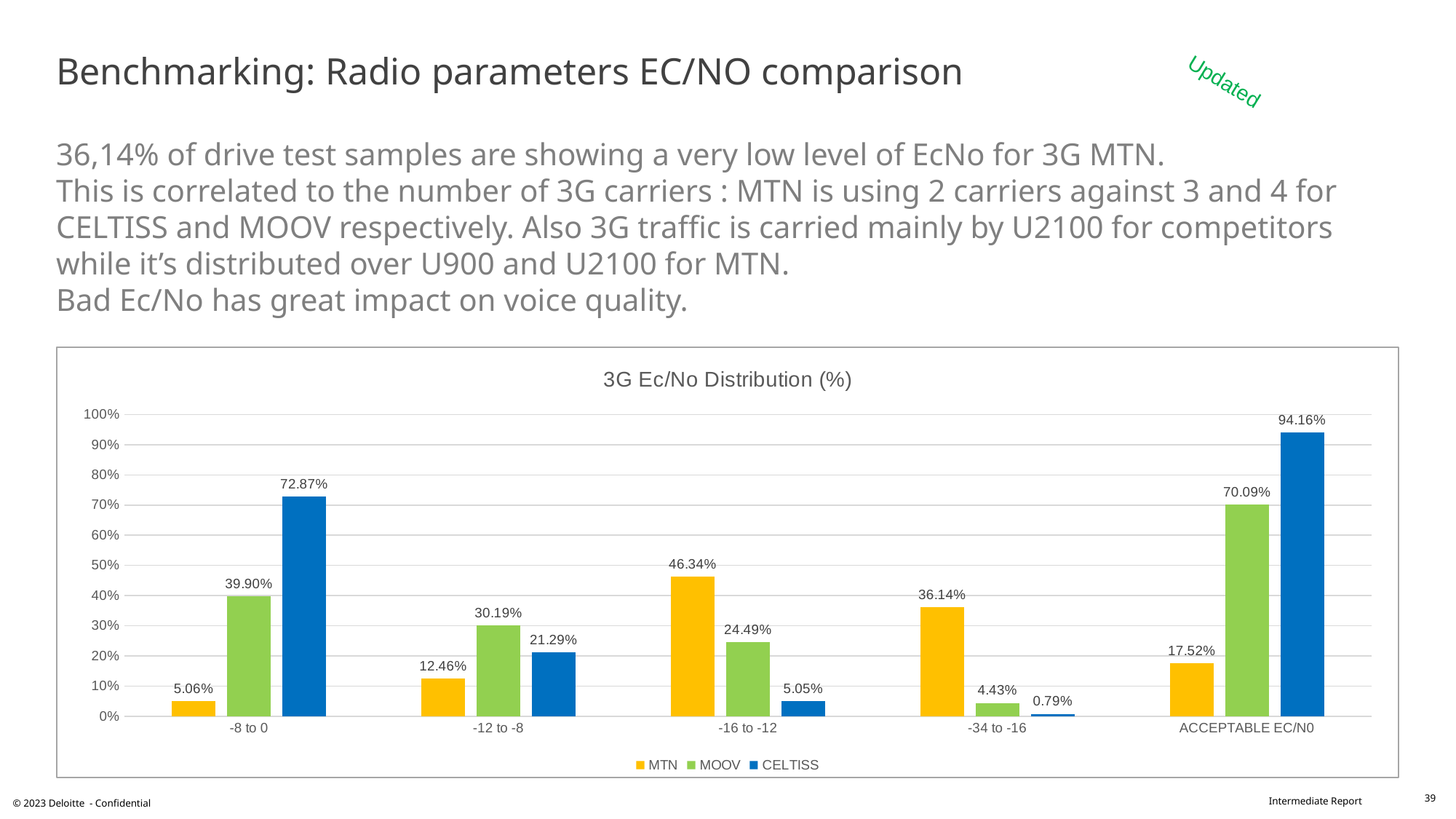
What is the value for MTN in the -34 to -16 category? 36.14% What is the value for CELTISS in the -8 to 0 category? 72.87% Which series has the highest value in the -16 to -12 category? MTN What is the difference between CELTISS and MTN in the ACCEPTABLE EC/N0 category? 76.64% Which is larger in the -12 to -8 category, MOOV or CELTISS? MOOV What is the title of the chart? 3G Ec/No Distribution (%) Is the value for CELTISS in the ACCEPTABLE EC/N0 category greater or less than 90%? greater What kind of chart is shown on the slide? Bar chart How many categories are shown on the x axis? 5 Which series has the lowest value in the -34 to -16 category? CELTISS How many series does the legend list? 3 What is the value for MOOV in the ACCEPTABLE EC/N0 category? 70.09%